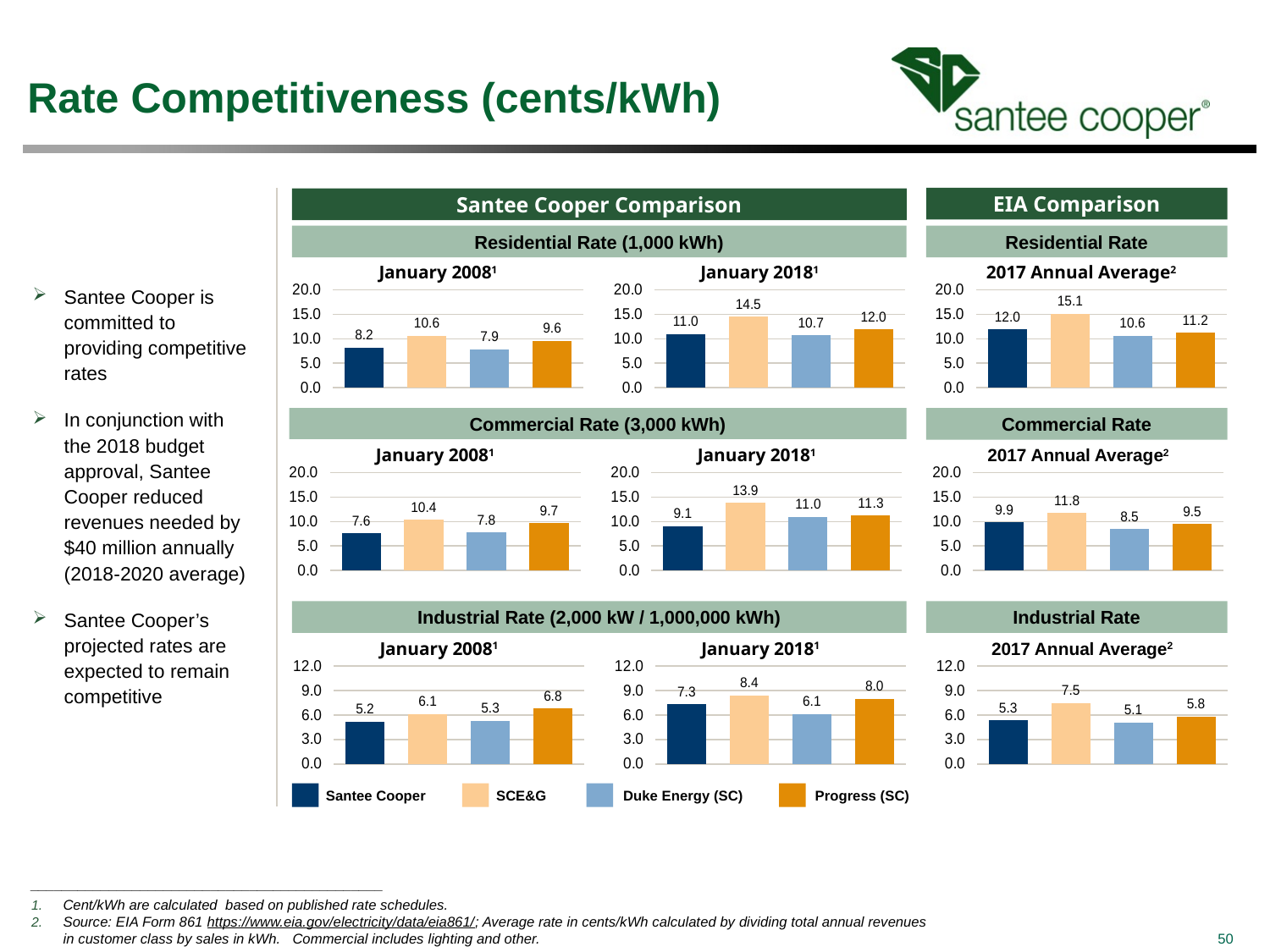
In the EIA Comparison Industrial Rate 2017 Annual Average chart, what is the value for SCE&G? 7.5 In the Commercial Rate January 2008 chart, which is larger: Santee Cooper or Duke Energy (SC)? Duke Energy (SC) How many companies does the legend at the bottom of the slide list? 4 In the Commercial Rate January 2018 chart, what is the difference between SCE&G and Santee Cooper? 4.8 In the EIA Comparison Commercial Rate 2017 Annual Average chart, what is the value for Duke Energy (SC)? 8.5 In the Residential Rate January 2018 chart, which company has the highest rate? SCE&G In the EIA Comparison Residential Rate 2017 Annual Average chart, which company has the lowest rate? Duke Energy (SC) What kind of chart is used for the Residential Rate January 2008 comparison? Bar chart In the Industrial Rate January 2008 chart, is the value for Progress (SC) greater or less than 6.0? greater Which company is represented by the dark blue bars in the charts? Santee Cooper In the Residential Rate January 2008 chart, what is the value for Santee Cooper? 8.2 In the Industrial Rate January 2018 chart, what is the value for Progress (SC)? 8.0